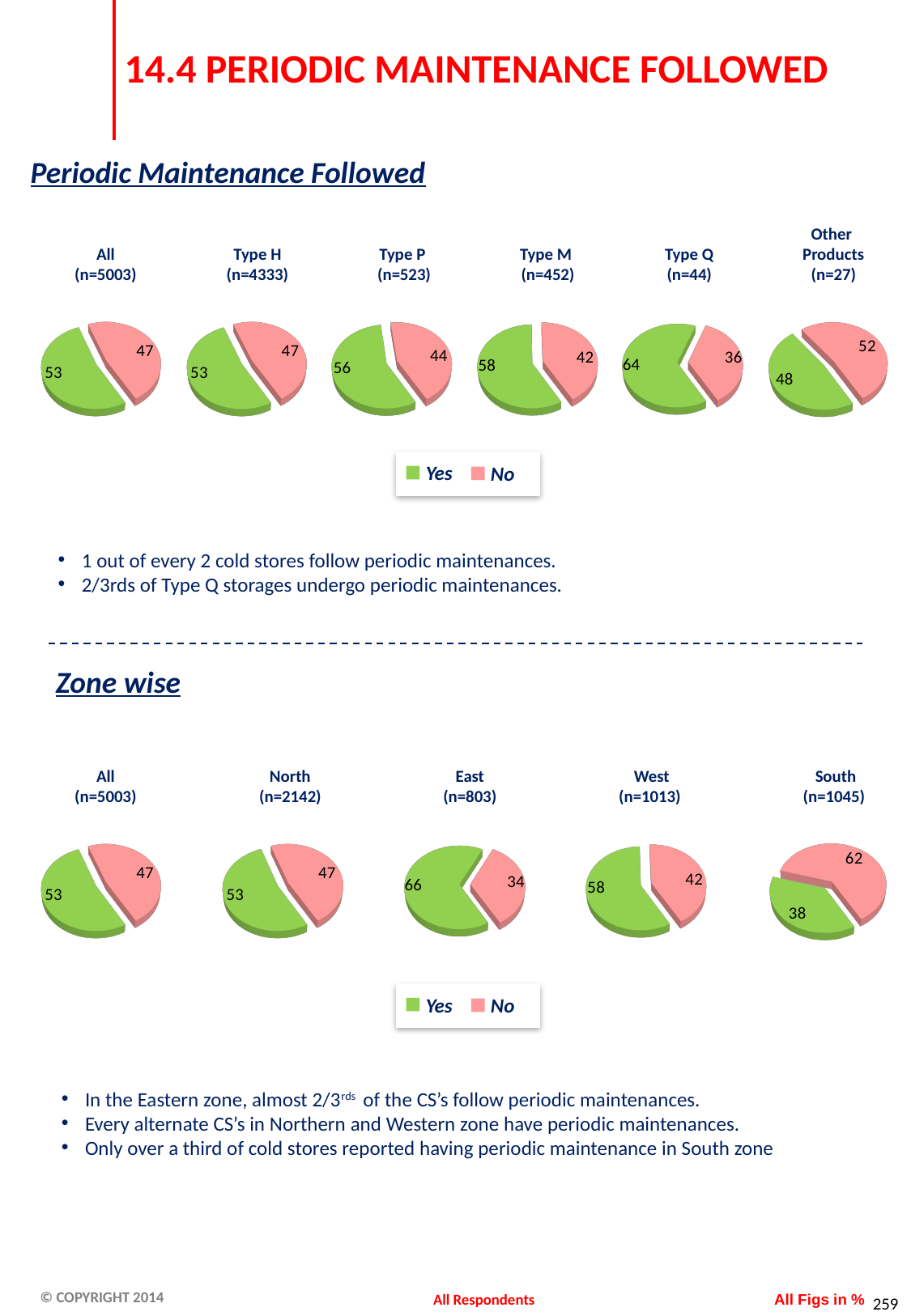
In the Periodic Maintenance Followed section, what is the No value in the Other Products (n=27) pie chart? 52 In the Periodic Maintenance Followed section, what is the Yes value in the Type Q (n=44) pie chart? 64 In the Zone wise section, what is the No value in the South (n=1045) pie chart? 62 How many pie charts are shown in the Zone wise section? 5 In the Zone wise section, is the Yes value larger in the East (n=803) pie chart or the West (n=1013) pie chart? East (n=803) In the Zone wise section, what is the Yes value in the East (n=803) pie chart? 66 In the Periodic Maintenance Followed section, which pie chart has the highest Yes value? Type Q (n=44) In the Periodic Maintenance Followed section, what is the difference between the Yes and No values in the Type M (n=452) pie chart? 16 How many series does the legend list for the Periodic Maintenance Followed charts? 2 What kind of chart is used in the Periodic Maintenance Followed section? Pie chart In the Zone wise section, what colour represents No in the legend? Pink In the Zone wise section, which pie chart has the lowest Yes value? South (n=1045)